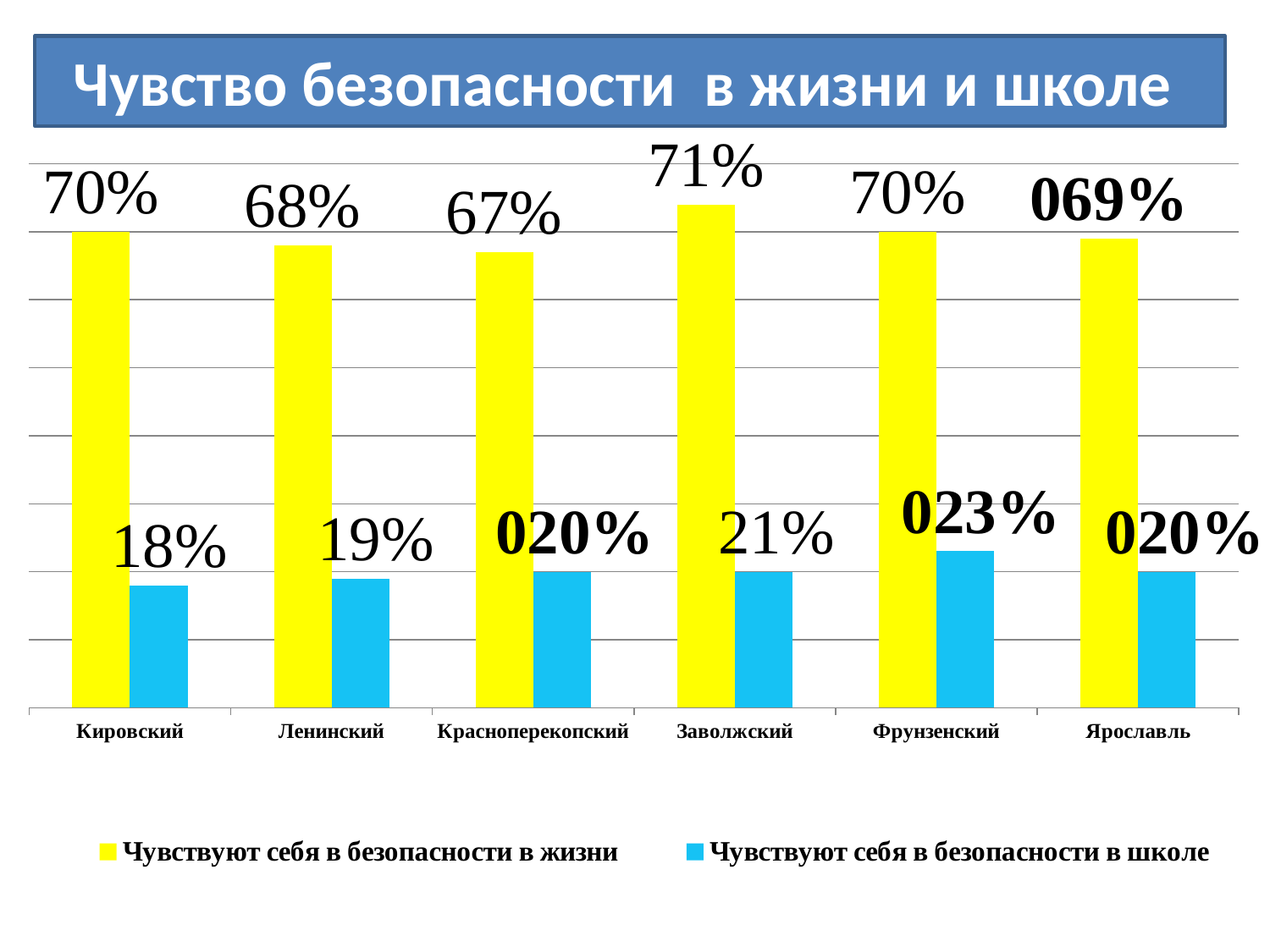
What is the difference between the 'Чувствуют себя в безопасности в жизни' value and the 'Чувствуют себя в безопасности в школе' value for Ленинский? 49% What is the value for Заволжский in the series 'Чувствуют себя в безопасности в школе'? 21% What is the value for Краснопереекопский in the series 'Чувствуют себя в безопасности в жизни'? 67% What is the value for Фрунзенский in the series 'Чувствуют себя в безопасности в школе'? 023% What type of chart is shown on the slide? bar chart Which category has the highest value in the series 'Чувствуют себя в безопасности в жизни'? Заволжский Which is larger: the 'Чувствуют себя в безопасности в школе' value for Фрунзенский or for Кировский? Фрунзенский What colour are the bars for the series 'Чувствуют себя в безопасности в школе'? blue How many categories are shown on the x axis? 6 How many series does the legend list? 2 Which category has the lowest value in the series 'Чувствуют себя в безопасности в школе'? Кировский What is the value for Кировский in the series 'Чувствуют себя в безопасности в жизни'? 70%